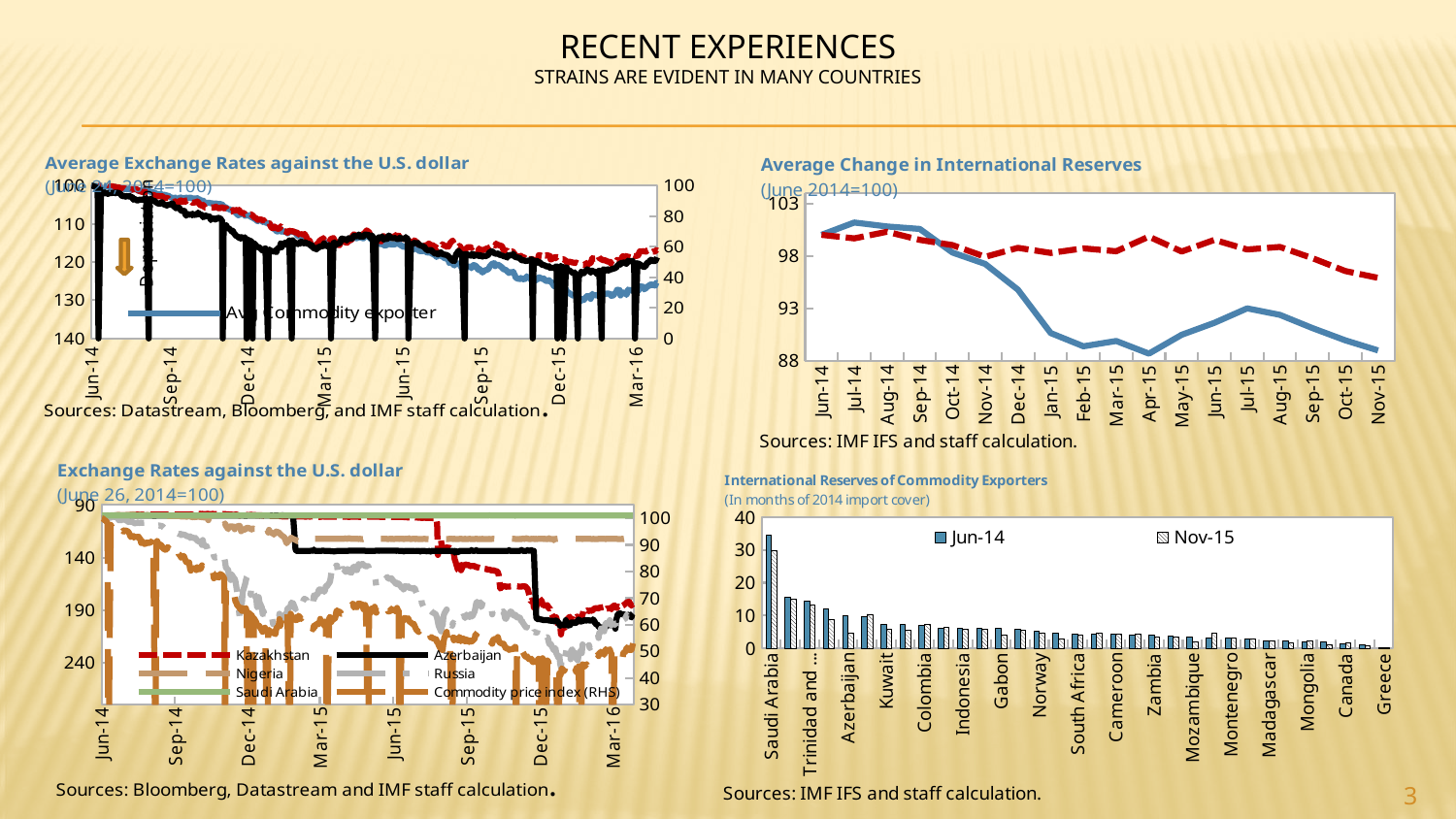
In the 'International Reserves of Commodity Exporters' chart, which country has the highest reserves in months of import cover? Saudi Arabia In the 'International Reserves of Commodity Exporters' chart, which labelled country has the lowest reserves? Greece In the 'International Reserves of Commodity Exporters' chart, is the Jun-14 value for Kuwait greater or less than 20? less What kind of chart is the 'Average Change in International Reserves' chart? line chart What kind of chart is the 'International Reserves of Commodity Exporters' chart? bar chart In the 'Average Change in International Reserves' chart, does the blue line rise or fall from Jun-14 to Nov-15? fall What is the base period stated in the subtitle of the 'Average Change in International Reserves' chart? June 2014=100 In the 'Average Change in International Reserves' chart, is the blue line's value at Nov-15 greater or less than 93? less How many series does the legend of the 'International Reserves of Commodity Exporters' chart list? 2 In the 'International Reserves of Commodity Exporters' chart, is the Jun-14 value for Saudi Arabia greater or less than 30? greater In the 'International Reserves of Commodity Exporters' chart, which is larger: the Jun-14 value for Saudi Arabia or the Jun-14 value for Azerbaijan? Saudi Arabia How many series does the legend of the 'Exchange Rates against the U.S. dollar' chart (bottom left) list? 6